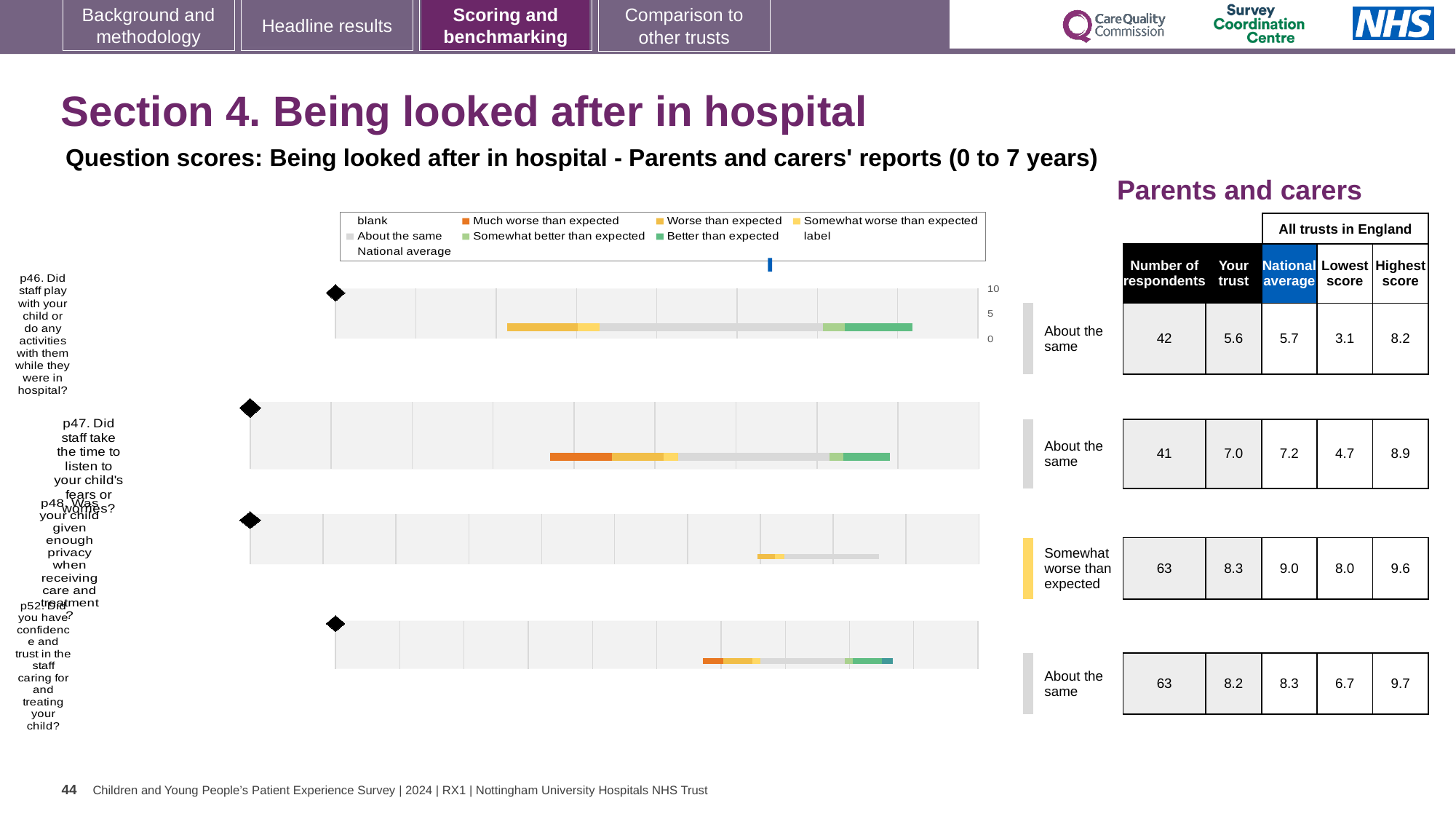
What is the lowest score across all trusts in England for p46? 3.1 Which question has the lowest 'Your trust' score? p46 What is the highest score across all trusts in England for p52 (Did you have confidence and trust in the staff caring for and treating your child?)? 9.7 What is the 'Your trust' score for p46 (Did staff play with your child or do any activities with them while they were in hospital?)? 5.6 How many survey questions are plotted in the chart? 4 Which question is rated 'Somewhat worse than expected'? p48 For p48, how much higher is the national average than the 'Your trust' score? 0.7 How many respondents answered p48 (Was your child given enough privacy when receiving care and treatment?)? 63 What is the national average score for p47 (Did staff take the time to listen to your child's fears or worries?)? 7.2 Which question has the highest 'Your trust' score? p48 What kind of chart is used to show the question scores on this slide? bar chart For p47, which is larger: the 'Your trust' score or the national average? National average